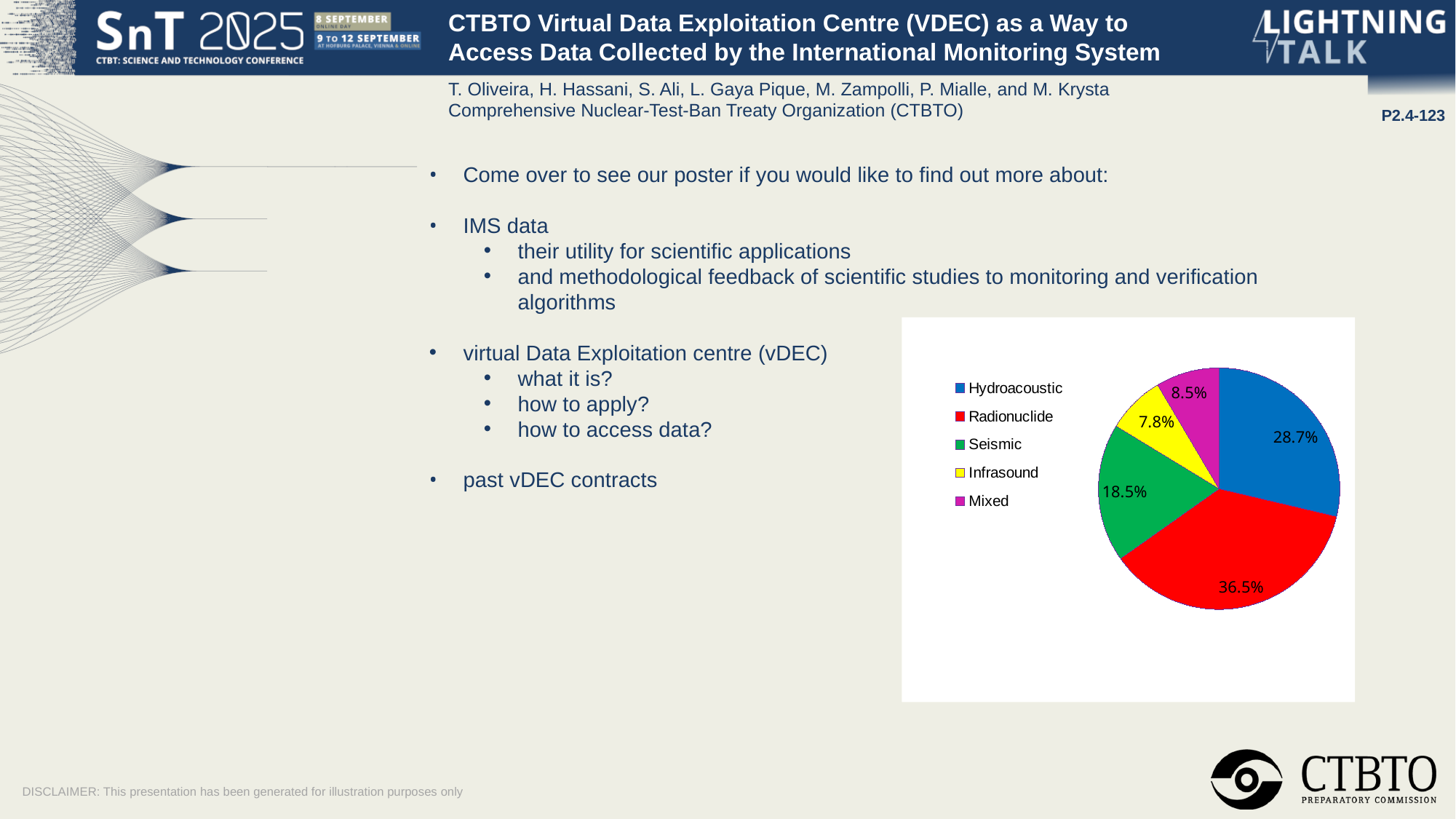
Which is larger, the Mixed slice or the Infrasound slice? Mixed Which category has the smallest slice of the pie? Infrasound What is the value shown for Mixed? 8.5% What is the value shown for Hydroacoustic? 28.7% How many categories does the pie chart have? 5 What colour is the Seismic slice in the pie chart? green What is the difference between the Radionuclide and Hydroacoustic shares? 7.8% Which category has the largest slice of the pie? Radionuclide What is the value shown for Infrasound? 7.8% What share of the pie does Radionuclide account for? 36.5% What is the value shown for Seismic? 18.5% What kind of chart is shown on the slide? pie chart